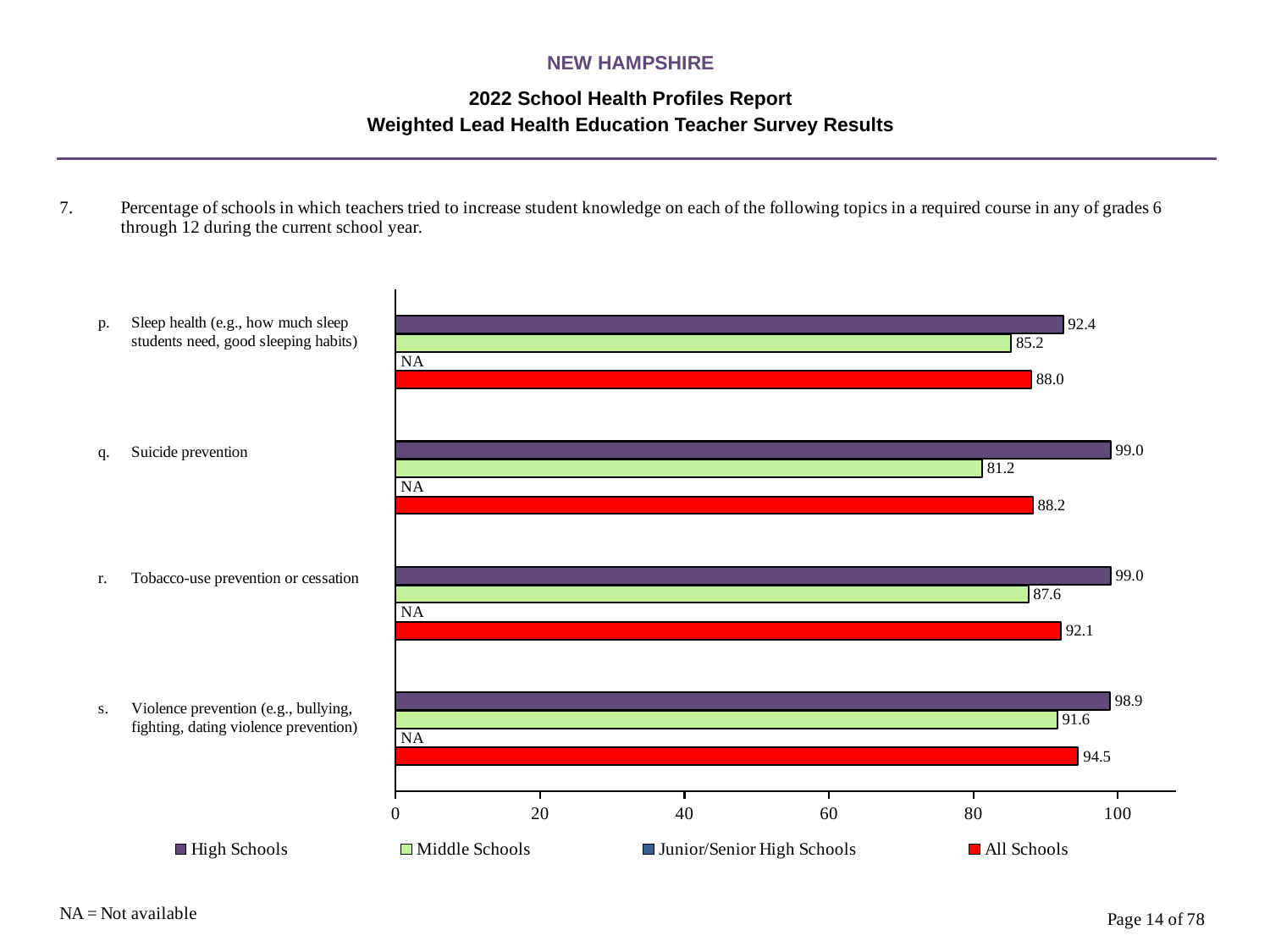
Which topic has the highest All Schools value? Violence prevention (e.g., bullying, fighting, dating violence prevention) Is the Middle Schools value for Tobacco-use prevention or cessation greater or less than 80? greater What is the Junior/Senior High Schools value for Tobacco-use prevention or cessation? NA Which topic has the lowest Middle Schools value? Suicide prevention What is the Middle Schools value for Sleep health? 85.2 What is the All Schools value for Violence prevention? 94.5 How many series does the legend list? 4 What is the difference between the High Schools and Middle Schools values for Suicide prevention? 17.8 How many topics are shown on the chart? 4 Which is larger for Sleep health: the High Schools value or the All Schools value? High Schools What kind of chart is shown on the slide? bar chart What is the High Schools value for Suicide prevention? 99.0